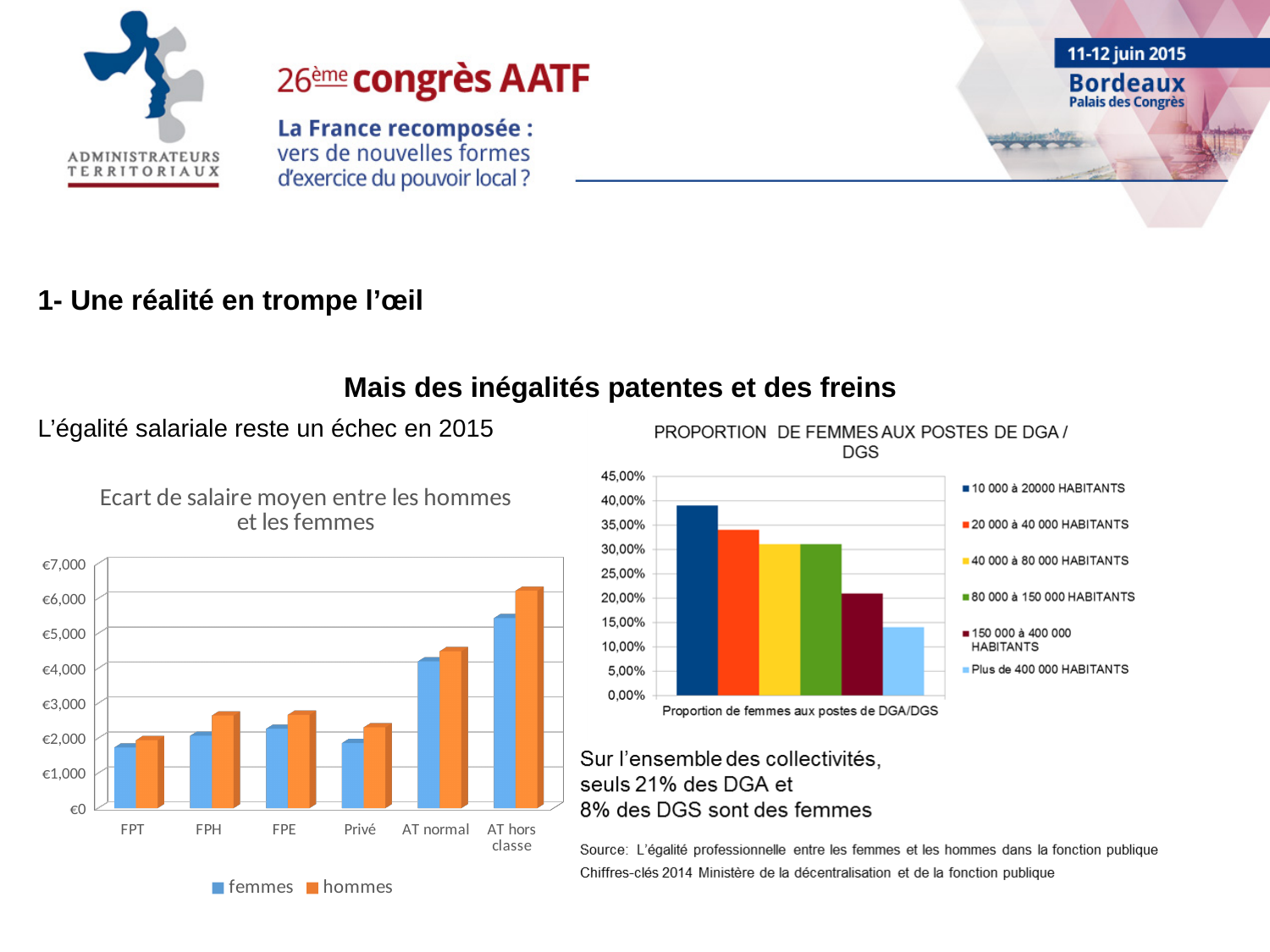
How many series does the legend of the 'Ecart de salaire moyen entre les hommes et les femmes' chart list? 2 In the 'PROPORTION DE FEMMES AUX POSTES DE DGA / DGS' chart, which population category has the highest proportion? 10 000 à 20000 HABITANTS How many categories are shown on the x axis of the 'Ecart de salaire moyen entre les hommes et les femmes' chart? 6 In the 'PROPORTION DE FEMMES AUX POSTES DE DGA / DGS' chart, which population category has the lowest proportion? Plus de 400 000 HABITANTS In the 'Ecart de salaire moyen entre les hommes et les femmes' chart, for AT hors classe, which is larger: femmes or hommes? hommes In the 'Ecart de salaire moyen entre les hommes et les femmes' chart, which category has the highest value for hommes? AT hors classe What kind of chart is the 'Ecart de salaire moyen entre les hommes et les femmes' chart? bar chart In the 'Ecart de salaire moyen entre les hommes et les femmes' chart, which category has the lowest value for hommes? FPT In the 'Ecart de salaire moyen entre les hommes et les femmes' chart, is the hommes value for FPH greater or less than €3,000? less In the 'Ecart de salaire moyen entre les hommes et les femmes' chart, is the hommes value for AT normal greater or less than €4,000? greater How many bars are shown in the 'PROPORTION DE FEMMES AUX POSTES DE DGA / DGS' chart? 6 In the 'PROPORTION DE FEMMES AUX POSTES DE DGA / DGS' chart, is the value for 10 000 à 20000 HABITANTS greater or less than 35,00%? greater